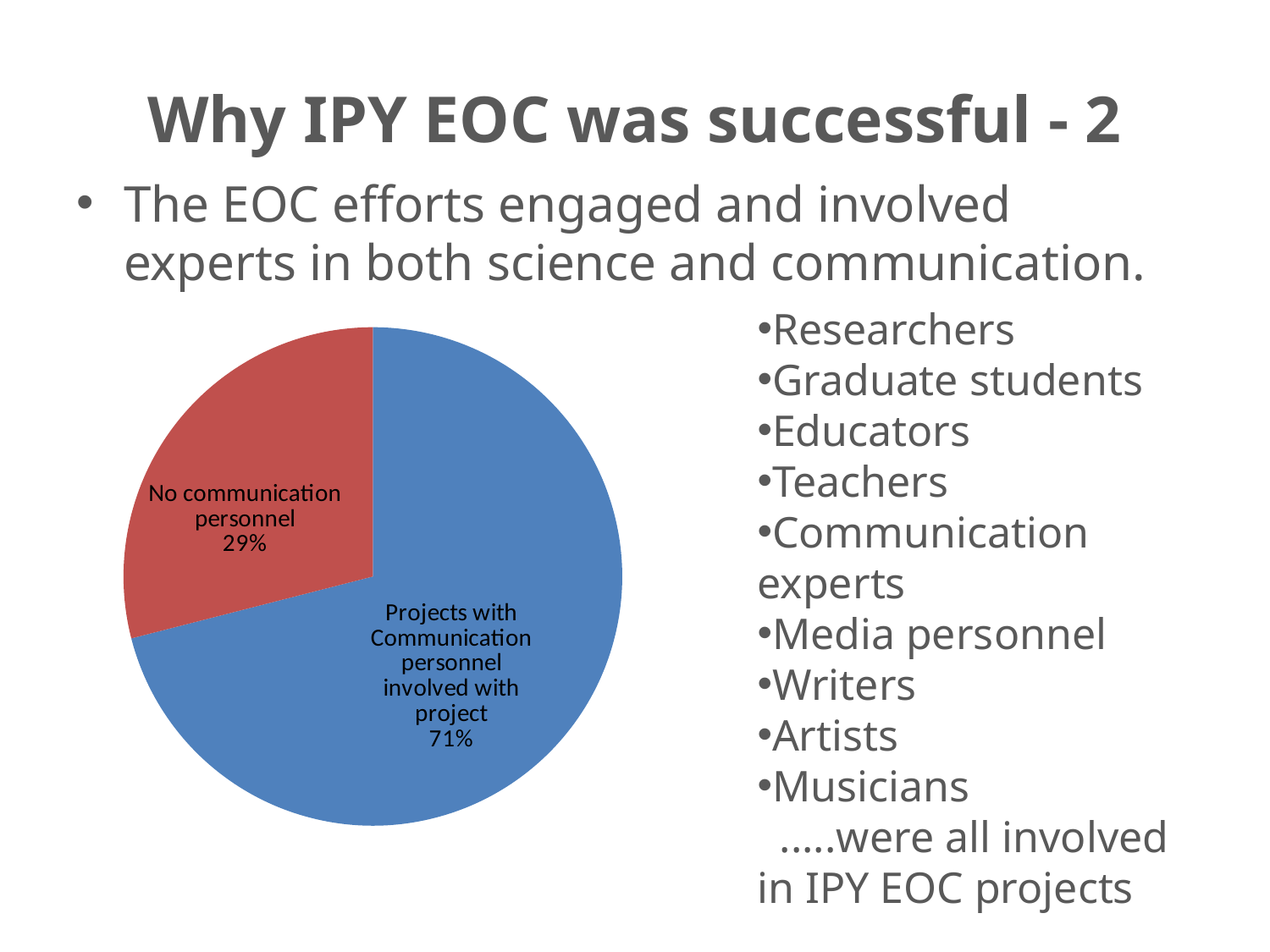
What kind of chart is shown on the slide? pie chart What colour is the "Projects with Communication personnel involved with project" slice? blue Which slice of the pie chart is the smallest? No communication personnel What is the total of the two percentages shown on the pie chart? 100% What share of the pie is labelled "No communication personnel"? 29% Which is larger: the "No communication personnel" slice or the "Projects with Communication personnel involved with project" slice? Projects with Communication personnel involved with project Which slice of the pie chart is the largest? Projects with Communication personnel involved with project What colour is the "No communication personnel" slice? red What share of the pie is labelled "Projects with Communication personnel involved with project"? 71% How many slices does the pie chart have? 2 What is the difference in percentage points between the "Projects with Communication personnel involved with project" slice and the "No communication personnel" slice? 42